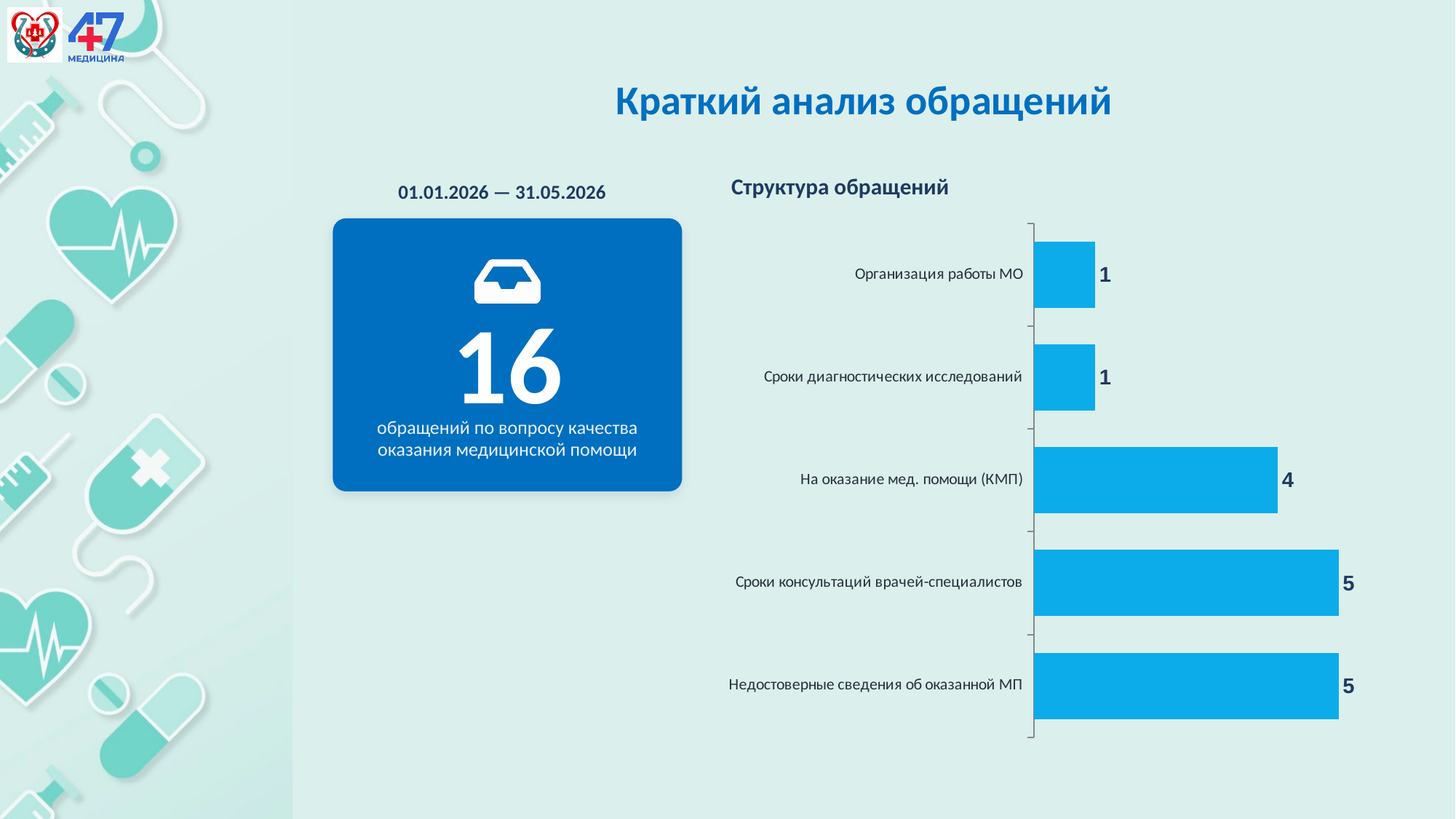
What is the value for «Организация работы МО» in the «Структура обращений» chart? 1 What is the value for «Сроки консультаций врачей-специалистов» in the «Структура обращений» chart? 5 What is the title of the chart on the slide? Структура обращений What kind of chart is «Структура обращений»? bar chart Which is larger in the «Структура обращений» chart: «Организация работы МО» or «На оказание мед. помощи (КМП)»? На оказание мед. помощи (КМП) What is the value for «Недостоверные сведения об оказанной МП» in the «Структура обращений» chart? 5 What is the value for «На оказание мед. помощи (КМП)» in the «Структура обращений» chart? 4 How many categories are shown in the «Структура обращений» chart? 5 What is the difference between «Сроки консультаций врачей-специалистов» and «На оказание мед. помощи (КМП)» in the «Структура обращений» chart? 1 Which is larger in the «Структура обращений» chart: «На оказание мед. помощи (КМП)» or «Сроки консультаций врачей-специалистов»? Сроки консультаций врачей-специалистов What is the value for «Сроки диагностических исследований» in the «Структура обращений» chart? 1 What is the difference between «Недостоверные сведения об оказанной МП» and «Сроки диагностических исследований» in the «Структура обращений» chart? 4